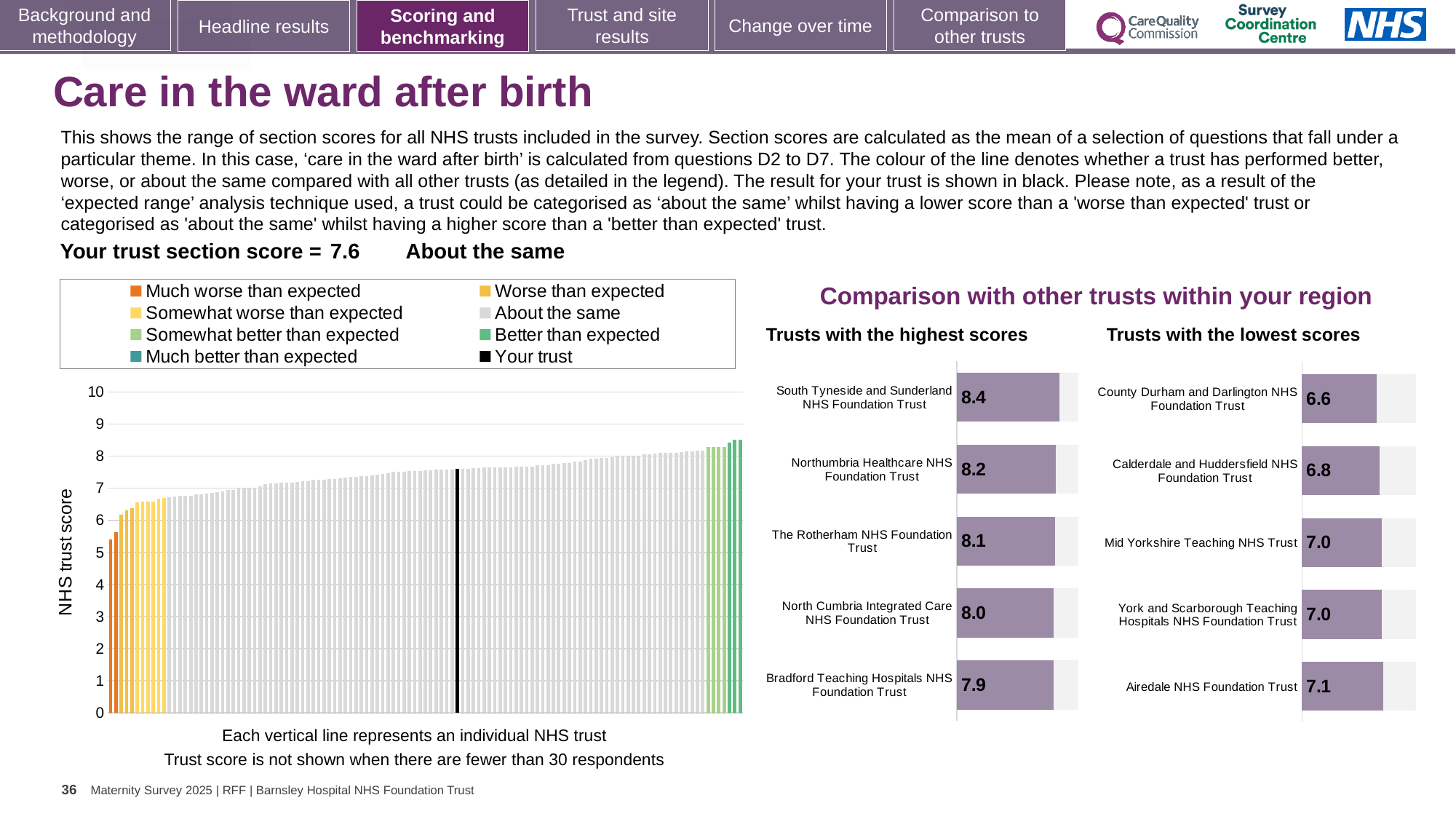
In the 'Trusts with the lowest scores' chart, which trust has the lowest score? County Durham and Darlington NHS Foundation Trust In the 'Trusts with the highest scores' chart, which has the higher score: Northumbria Healthcare NHS Foundation Trust or North Cumbria Integrated Care NHS Foundation Trust? Northumbria Healthcare NHS Foundation Trust In the 'Trusts with the highest scores' chart, what is the difference between the scores of South Tyneside and Sunderland NHS Foundation Trust and Bradford Teaching Hospitals NHS Foundation Trust? 0.5 How many trusts are shown in the 'Trusts with the lowest scores' chart? 5 What kind of chart is the 'Trusts with the highest scores' chart? Bar chart In the main chart on the left, do the trust scores rise or fall from left to right? Rise In the 'Trusts with the lowest scores' chart, what is the score for Airedale NHS Foundation Trust? 7.1 In the 'Trusts with the highest scores' chart, what is the score for South Tyneside and Sunderland NHS Foundation Trust? 8.4 How many entries does the legend of the main chart on the left list? 8 In the 'Trusts with the lowest scores' chart, what is the difference between the scores of Airedale NHS Foundation Trust and County Durham and Darlington NHS Foundation Trust? 0.5 In the 'Trusts with the highest scores' chart, which trust has the lowest score? Bradford Teaching Hospitals NHS Foundation Trust In the main chart on the left showing all NHS trusts, what is the section score for your trust (the black bar)? 7.6